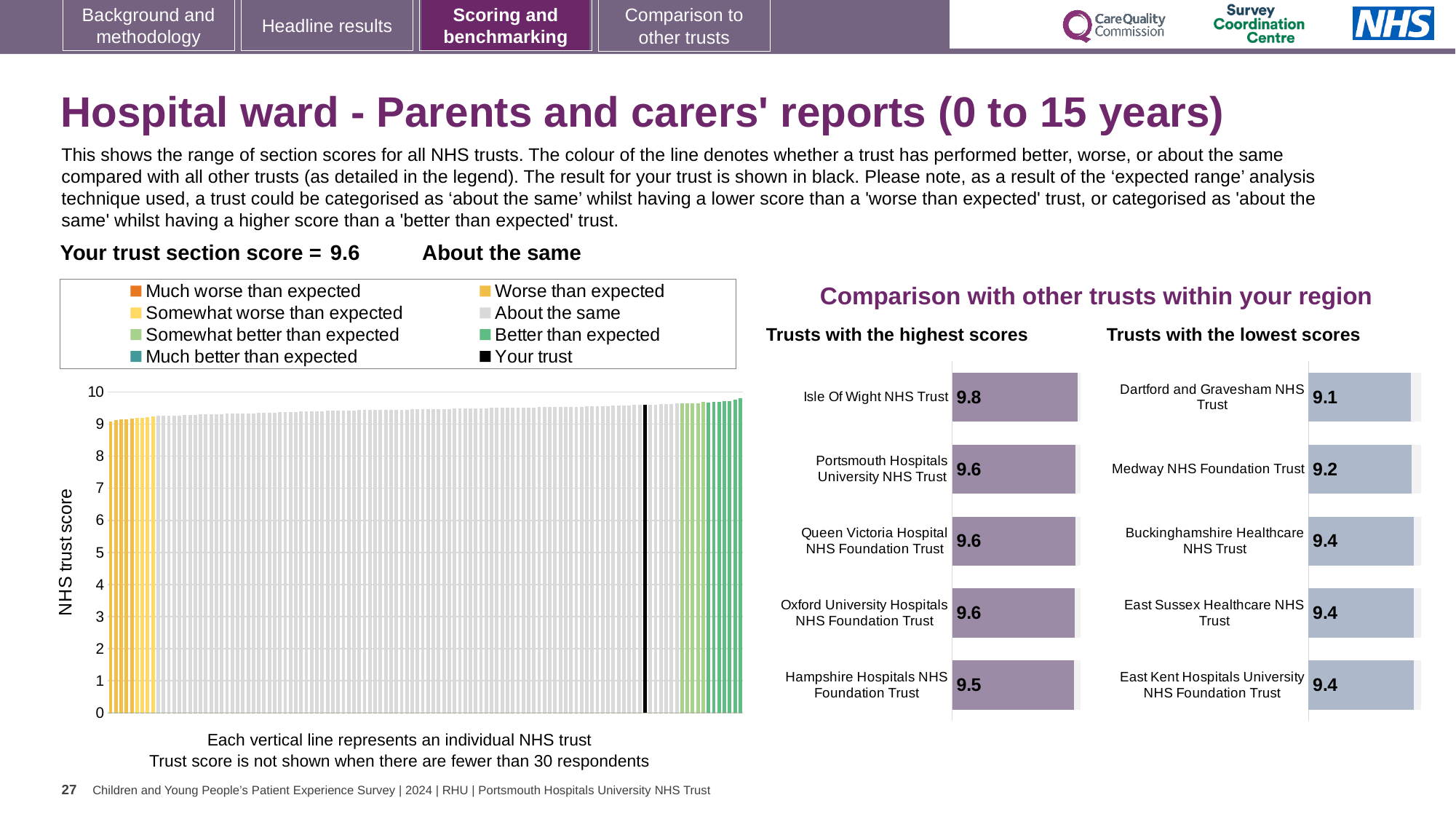
In the 'NHS trust score' chart on the left, what colour represents 'Your trust' according to the legend? Black In the 'Trusts with the highest scores' chart, what is the score for Isle Of Wight NHS Trust? 9.8 How many entries does the legend of the 'NHS trust score' chart on the left list? 8 In the 'NHS trust score' chart on the left, do the values rise or fall from left to right along the x axis? Rise In the 'Trusts with the lowest scores' chart, which trust has the lowest score? Dartford and Gravesham NHS Trust How many trusts are listed in the 'Trusts with the highest scores' chart? 5 In the 'Trusts with the lowest scores' chart, what is the score for Medway NHS Foundation Trust? 9.2 In the 'Trusts with the highest scores' chart, which trust has the highest score? Isle Of Wight NHS Trust In the 'Trusts with the lowest scores' chart, which has the larger score: Medway NHS Foundation Trust or Dartford and Gravesham NHS Trust? Medway NHS Foundation Trust In the 'NHS trust score' chart on the left, is the value for the black bar (Your trust) greater or less than 8? greater In the 'Trusts with the highest scores' chart, what is the difference between the scores of Isle Of Wight NHS Trust and Hampshire Hospitals NHS Foundation Trust? 0.3 What kind of chart is the 'NHS trust score' chart on the left of the slide? Bar chart